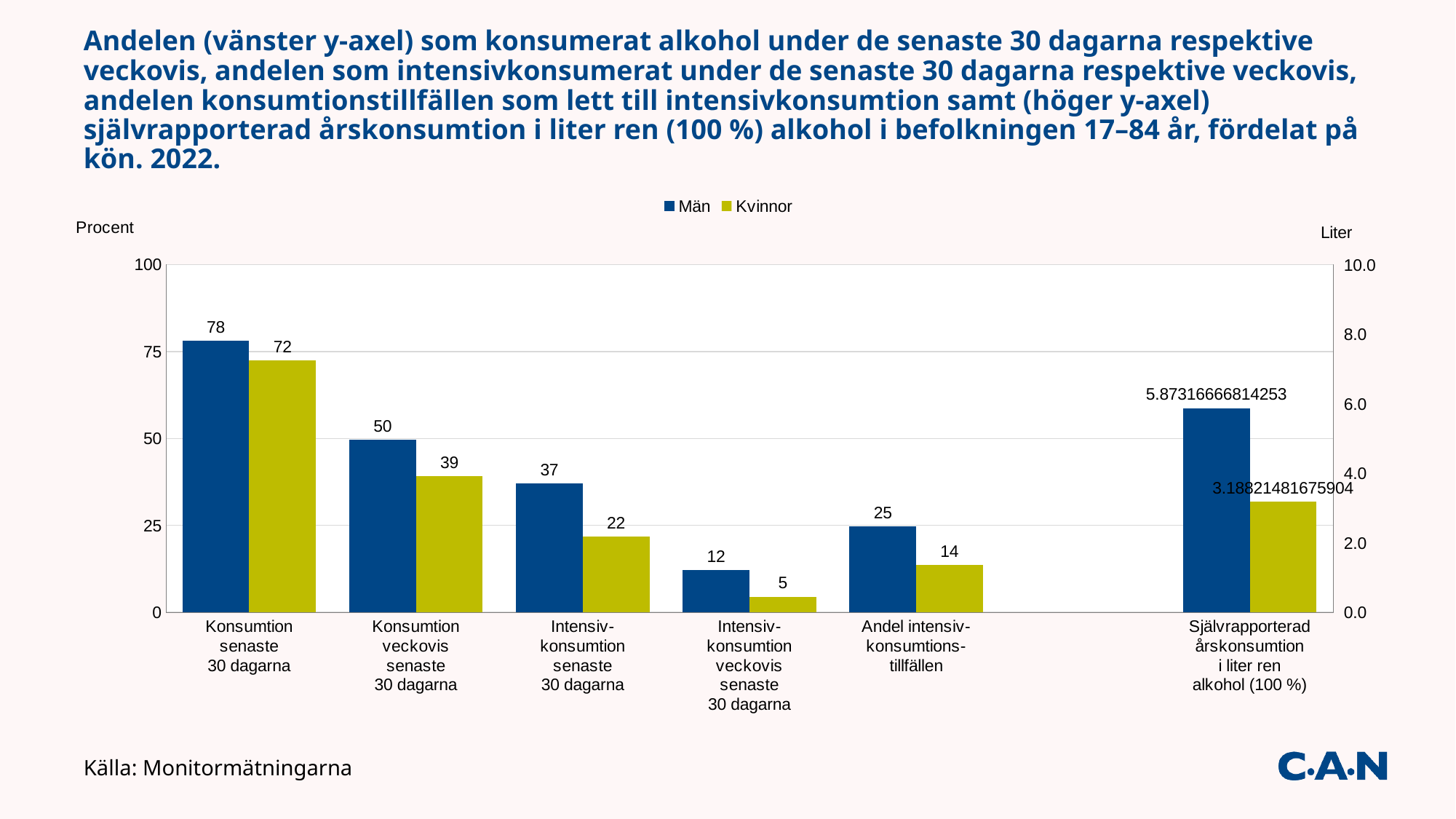
What kind of chart is shown on the slide? Bar chart What is the value for Kvinnor for 'Intensivkonsumtion veckovis senaste 30 dagarna'? 5 What is the data label shown for Kvinnor for 'Självrapporterad årskonsumtion i liter ren alkohol (100 %)'? 3.18821481675904 How many categories are shown on the x axis? 6 What is the value for Kvinnor for 'Konsumtion veckovis senaste 30 dagarna'? 39 What is the value for Män for 'Konsumtion senaste 30 dagarna'? 78 What is the value for Män for 'Andel intensivkonsumtionstillfällen'? 25 Which category has the highest value for Män on the Procent axis? Konsumtion senaste 30 dagarna Which is larger for 'Konsumtion veckovis senaste 30 dagarna', Män or Kvinnor? Män What is the difference between Män and Kvinnor for 'Intensivkonsumtion senaste 30 dagarna'? 15 How many series does the legend list? 2 Which category has the lowest value for Kvinnor on the Procent axis? Intensivkonsumtion veckovis senaste 30 dagarna